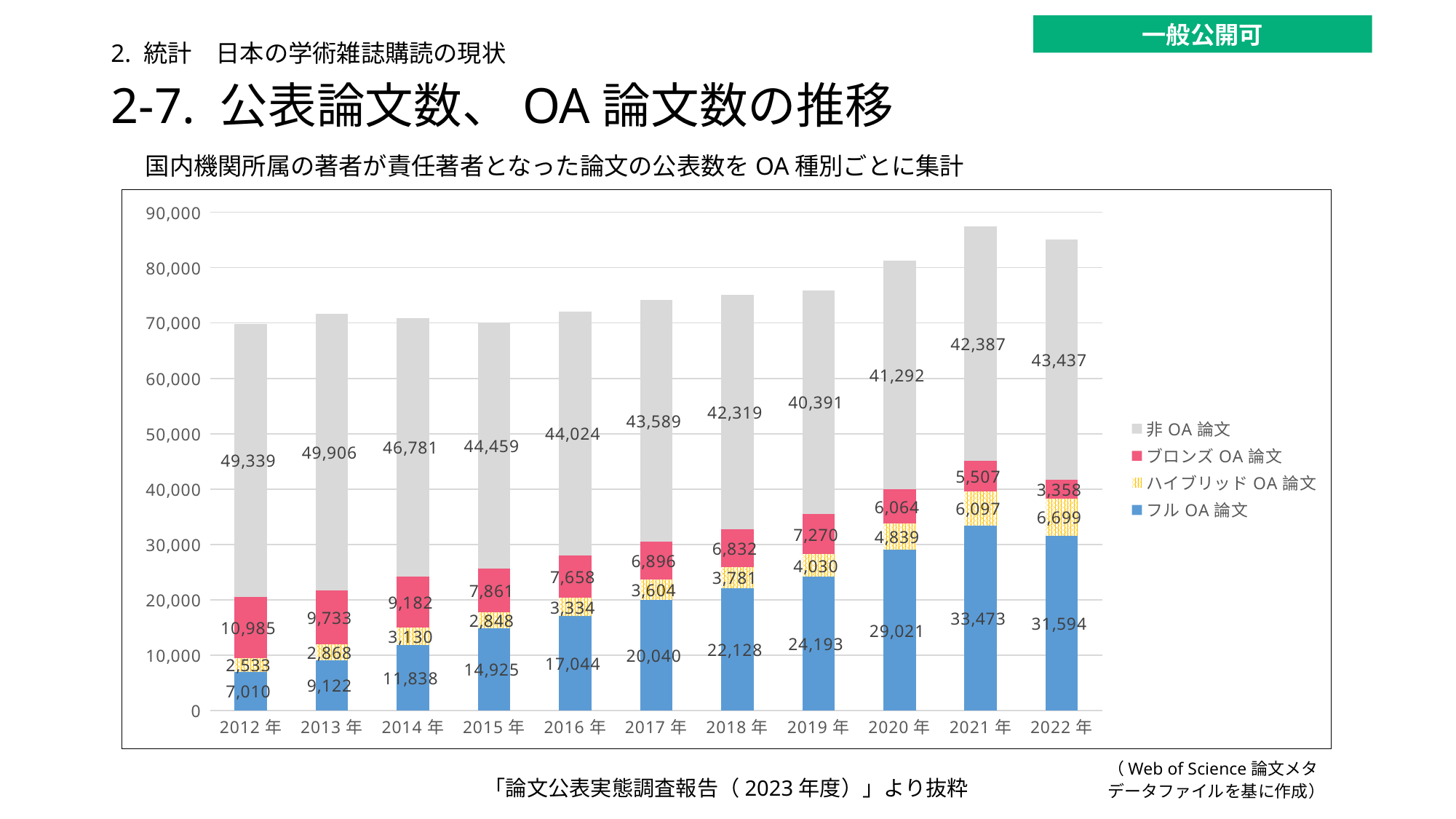
In which year is the value for フル OA 論文 highest? 2021 年 How many series does the legend list? 4 What is the value for ハイブリッド OA 論文 in 2019 年? 4,030 Is the total height of the stacked bar for 2021 年 greater or less than 80,000? greater Which is larger, the ブロンズ OA 論文 value in 2012 年 or in 2021 年? 2012 年 What is the difference between the 非 OA 論文 values for 2012 年 and 2022 年? 5,902 In which year is the value for ブロンズ OA 論文 lowest? 2022 年 What is the value for 非 OA 論文 in 2013 年? 49,906 What is the value for フル OA 論文 in 2020 年? 29,021 How many years are shown on the x axis? 11 What is the total of the stacked bar for 2012 年? 69,867 What kind of chart is shown on the slide? stacked bar chart